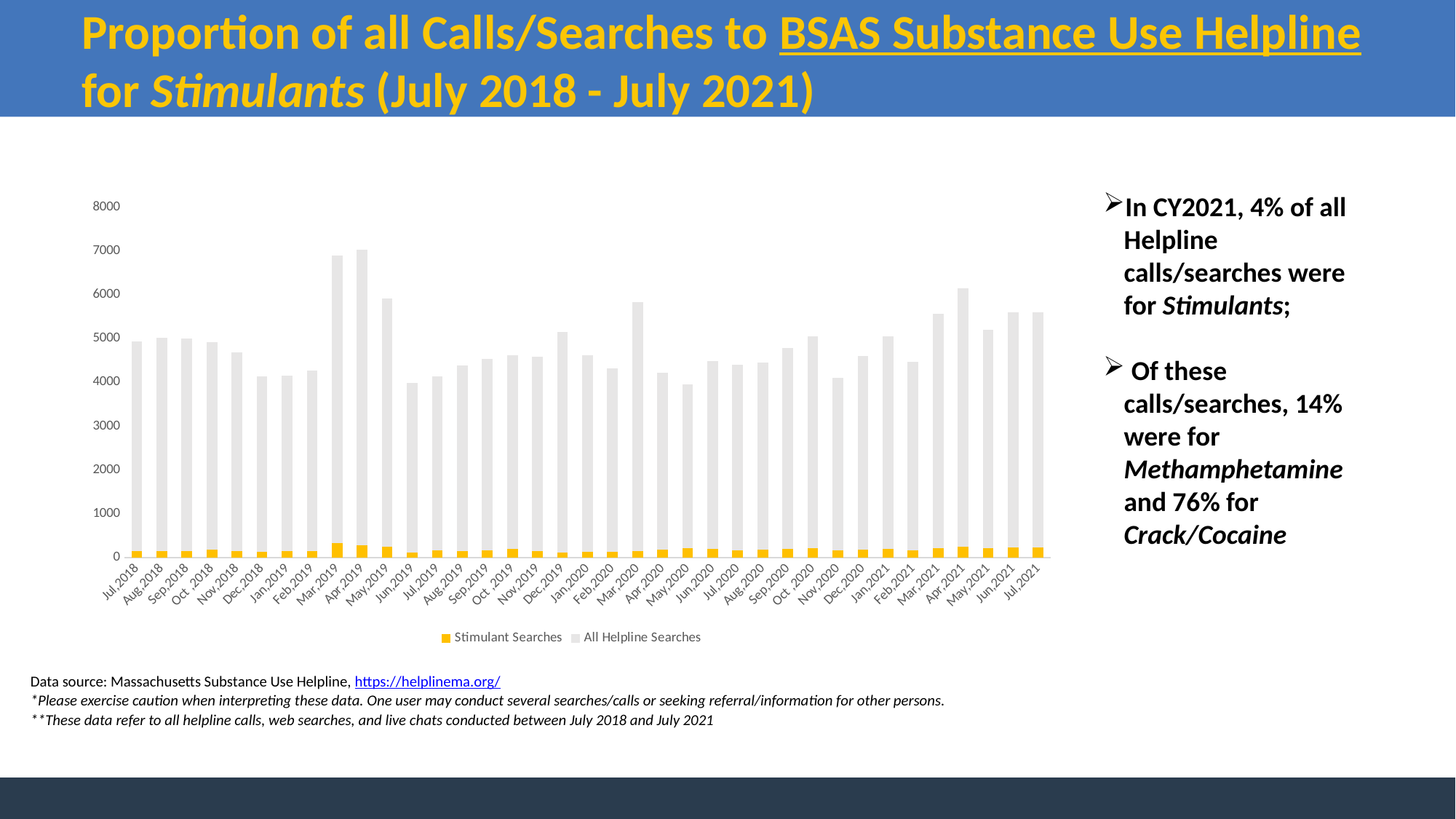
Is the value for All Helpline Searches in Nov 2020 greater or less than 5000? less Which month has the tallest bar for All Helpline Searches? Apr 2019 Is the value for Stimulant Searches in Mar 2019 greater or less than 1000? less Is the value for All Helpline Searches in Mar 2020 greater or less than 5000? greater How many months are plotted along the x axis of the chart? 37 Which is larger for All Helpline Searches: Apr 2021 or Mar 2021? Apr 2021 Which series is shown in yellow in the chart legend? Stimulant Searches Which is larger for All Helpline Searches: Mar 2020 or Feb 2020? Mar 2020 How many series does the chart legend list? 2 Do the All Helpline Searches values generally rise or fall from Jul 2018 to Dec 2018? fall What kind of chart is shown on the slide? Bar chart